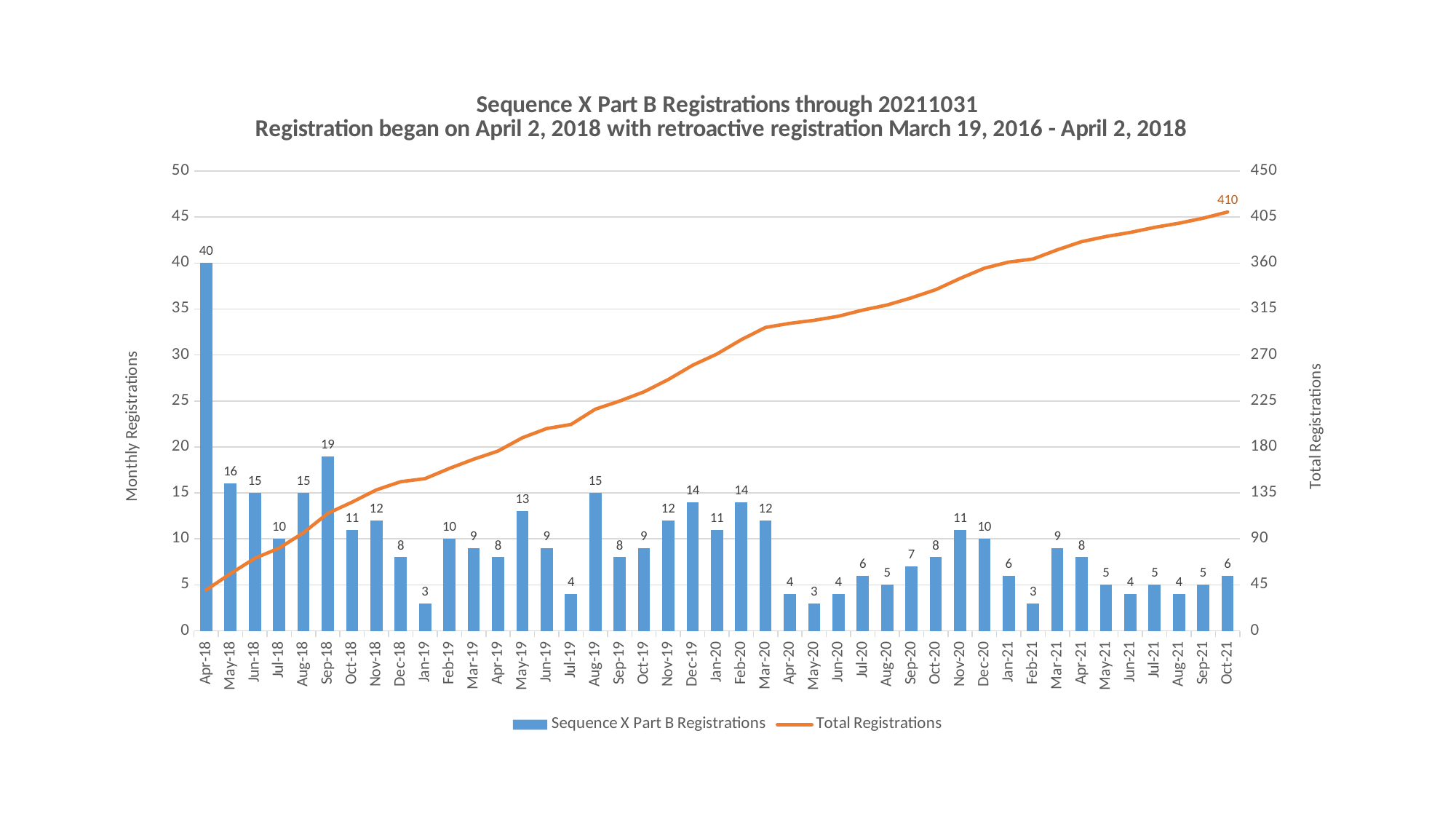
What is the value of Sequence X Part B Registrations for Apr-18? 40 Which month has the highest Sequence X Part B Registrations? Apr-18 What is the value of Sequence X Part B Registrations for Sep-18? 19 Is the Total Registrations value for Jan-19 greater or less than 180? less How many months are shown on the x axis? 43 Is the Total Registrations value for Mar-20 greater or less than 270? greater What is the Total Registrations value labeled at Oct-21? 410 What kind of chart is this? Combined bar and line chart How many series does the legend list? 2 Does the Total Registrations line rise or fall from Apr-18 to Oct-21? Rise Which is larger, Sequence X Part B Registrations in Aug-19 or in Dec-19? Aug-19 What is the difference between Sequence X Part B Registrations in Apr-18 and May-18? 24